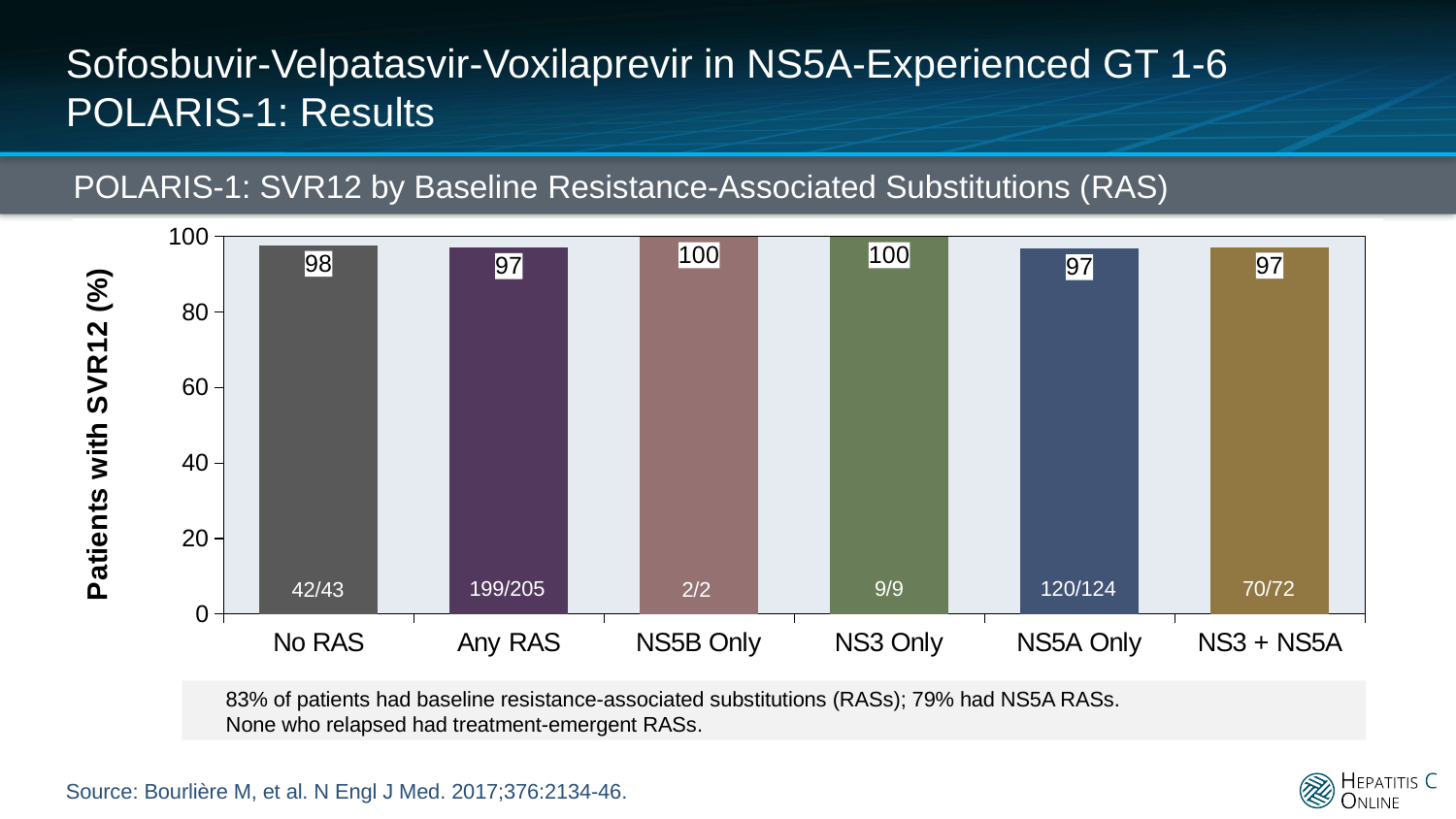
Is the SVR12 rate for the NS3 + NS5A group greater or less than 80? greater How many categories are shown on the x axis? 6 Which has a higher SVR12 rate, No RAS or NS5A Only? No RAS What kind of chart is shown on the slide? Bar chart What fraction of patients is shown at the base of the Any RAS bar? 199/205 Which categories have the highest SVR12 rate? NS5B Only and NS3 Only What is the SVR12 rate for the No RAS group? 98 What is the title of the chart? POLARIS-1: SVR12 by Baseline Resistance-Associated Substitutions (RAS) What fraction of patients is shown at the base of the NS3 + NS5A bar? 70/72 What is the SVR12 rate for the NS5A Only group? 97 What is the difference in SVR12 rate between the NS3 Only group and the Any RAS group? 3 What is the label of the y axis? Patients with SVR12 (%)